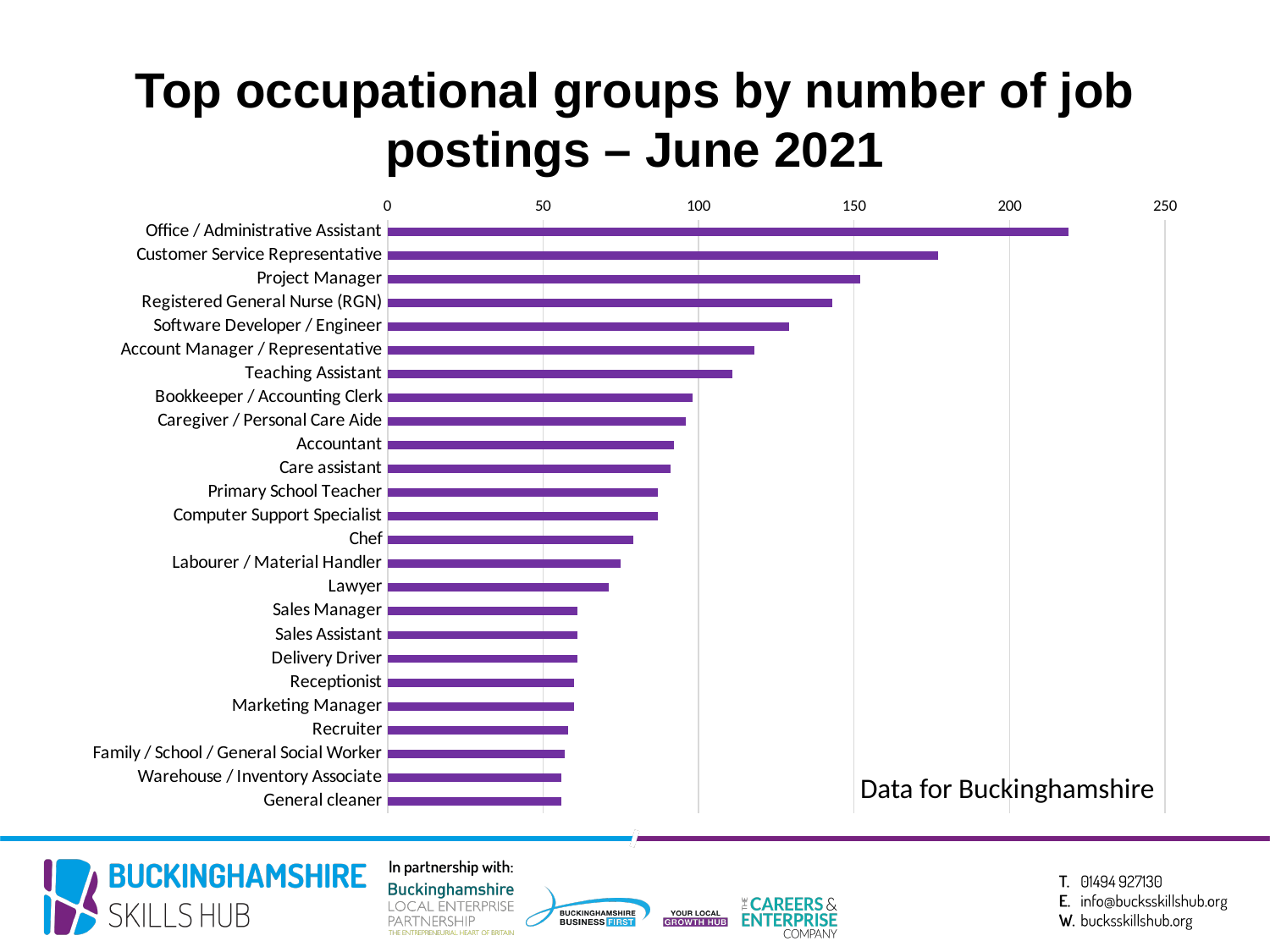
Which area does the chart state the data is for? Buckinghamshire Do the bars get longer or shorter going from the top of the chart to the bottom? shorter What kind of chart is shown on the slide? Bar chart How many occupational groups are plotted in the chart? 25 Is the value for Customer Service Representative greater or less than 150? greater Is the value for Office / Administrative Assistant greater or less than 200? greater Which has more job postings, Teaching Assistant or Accountant? Teaching Assistant Is the value for Chef greater or less than 100? less Which has more job postings, Chef or Lawyer? Chef Which occupational group has the highest number of job postings? Office / Administrative Assistant